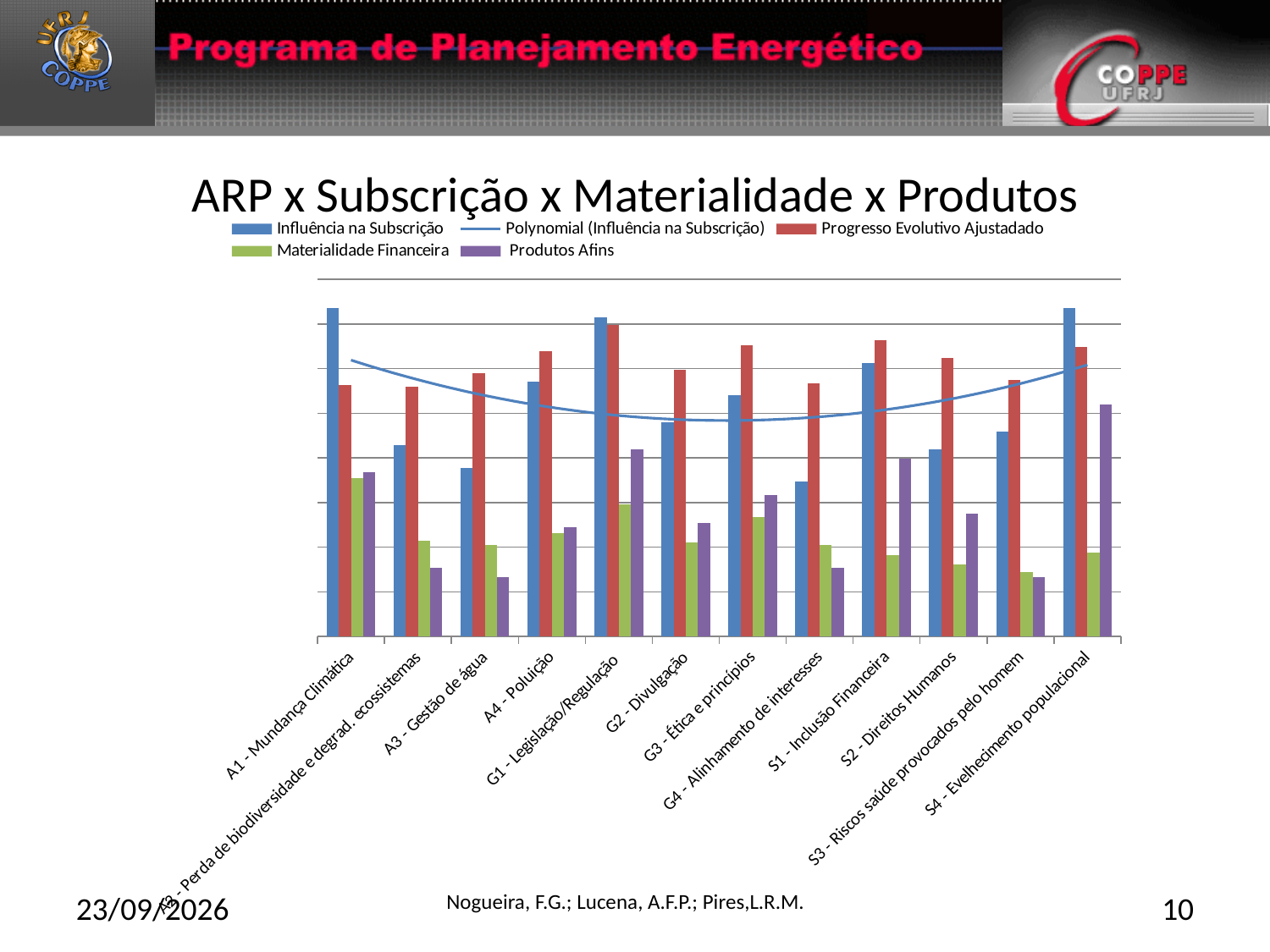
How many entries does the chart legend list? 5 What kind of chart is shown on the slide? Bar chart Which category has the highest value for Materialidade Financeira? A1 - Mundança Climática Does the Polynomial (Influência na Subscrição) trendline rise or fall from A1 - Mundança Climática to G2 - Divulgação? Fall What is the title of the chart? ARP x Subscrição x Materialidade x Produtos Which series is shown in green in the chart? Materialidade Financeira For G3 - Ética e princípios, which is larger: Influência na Subscrição or Progresso Evolutivo Ajustado? Progresso Evolutivo Ajustado Which category has the lowest value for Influência na Subscrição? G4 - Alinhamento de interesses For A1 - Mundança Climática, which is larger: Influência na Subscrição or Progresso Evolutivo Ajustado? Influência na Subscrição How many categories are shown along the x axis of the chart? 12 Which category has the highest value for Produtos Afins? S4 - Evelhecimento populacional Which category has the highest value for Progresso Evolutivo Ajustado? G1 - Legislação/Regulação